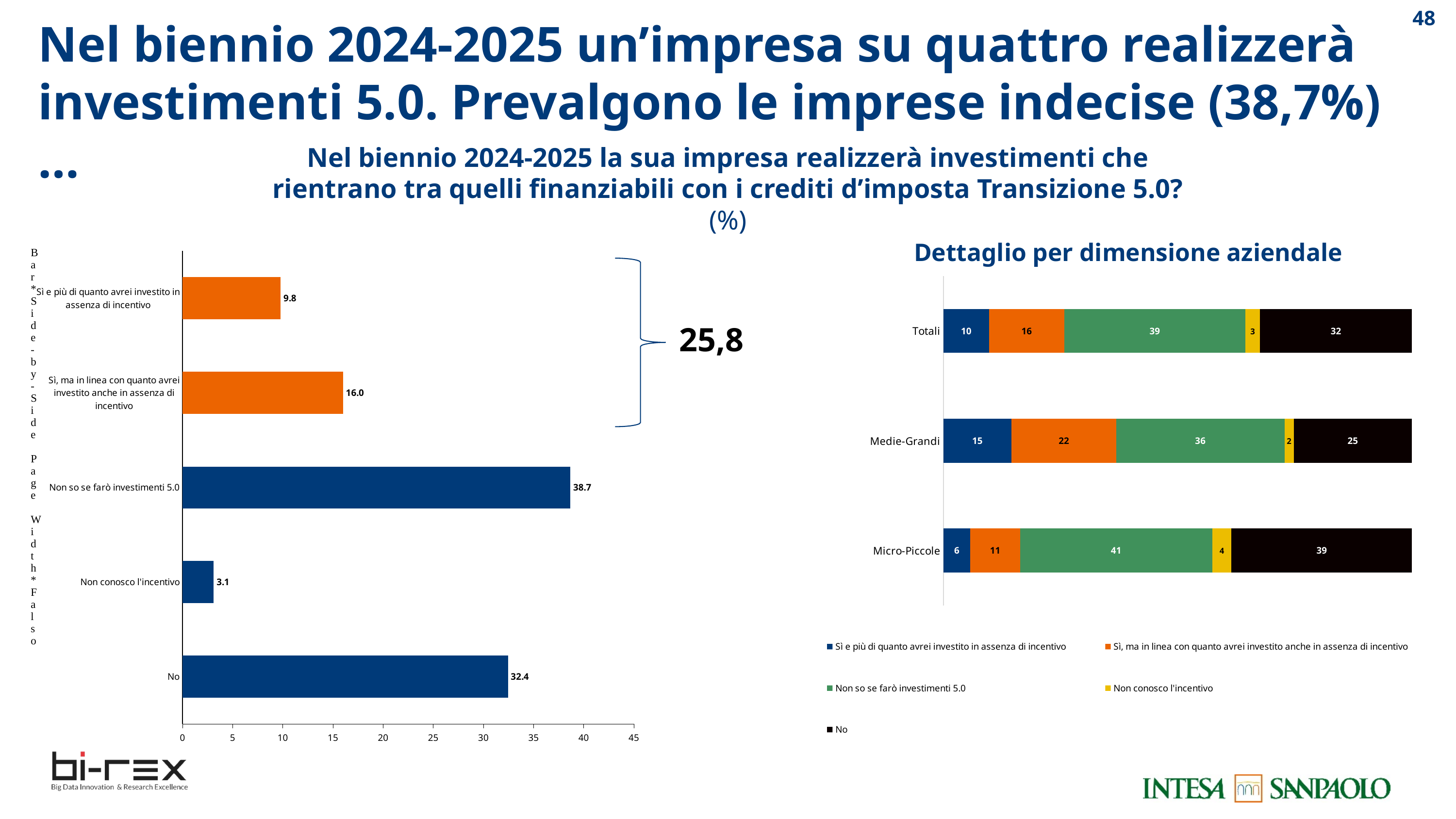
In the "Dettaglio per dimensione aziendale" chart, what is the total of the Totali bar? 100 In the left bar chart, how many categories are plotted? 5 In the "Dettaglio per dimensione aziendale" chart, what is the value of "No" for Medie-Grandi? 25 In the left bar chart, what is the difference between "Sì, ma in linea con quanto avrei investito anche in assenza di incentivo" and "Sì e più di quanto avrei investito in assenza di incentivo"? 6.2 What kind of chart is the "Dettaglio per dimensione aziendale" chart? Stacked bar chart In the "Dettaglio per dimensione aziendale" chart, what is the value of "Non so se farò investimenti 5.0" for Micro-Piccole? 41 How many series does the legend of the "Dettaglio per dimensione aziendale" chart list? 5 In the left bar chart, which category has the lowest value? Non conosco l'incentivo In the left bar chart, what is the value for "No"? 32.4 In the "Dettaglio per dimensione aziendale" chart, which is larger: the "Sì e più di quanto avrei investito in assenza di incentivo" value for Medie-Grandi or for Micro-Piccole? Medie-Grandi In the left bar chart, what is the value for "Non so se farò investimenti 5.0"? 38.7 In the left bar chart, which category has the highest value? Non so se farò investimenti 5.0